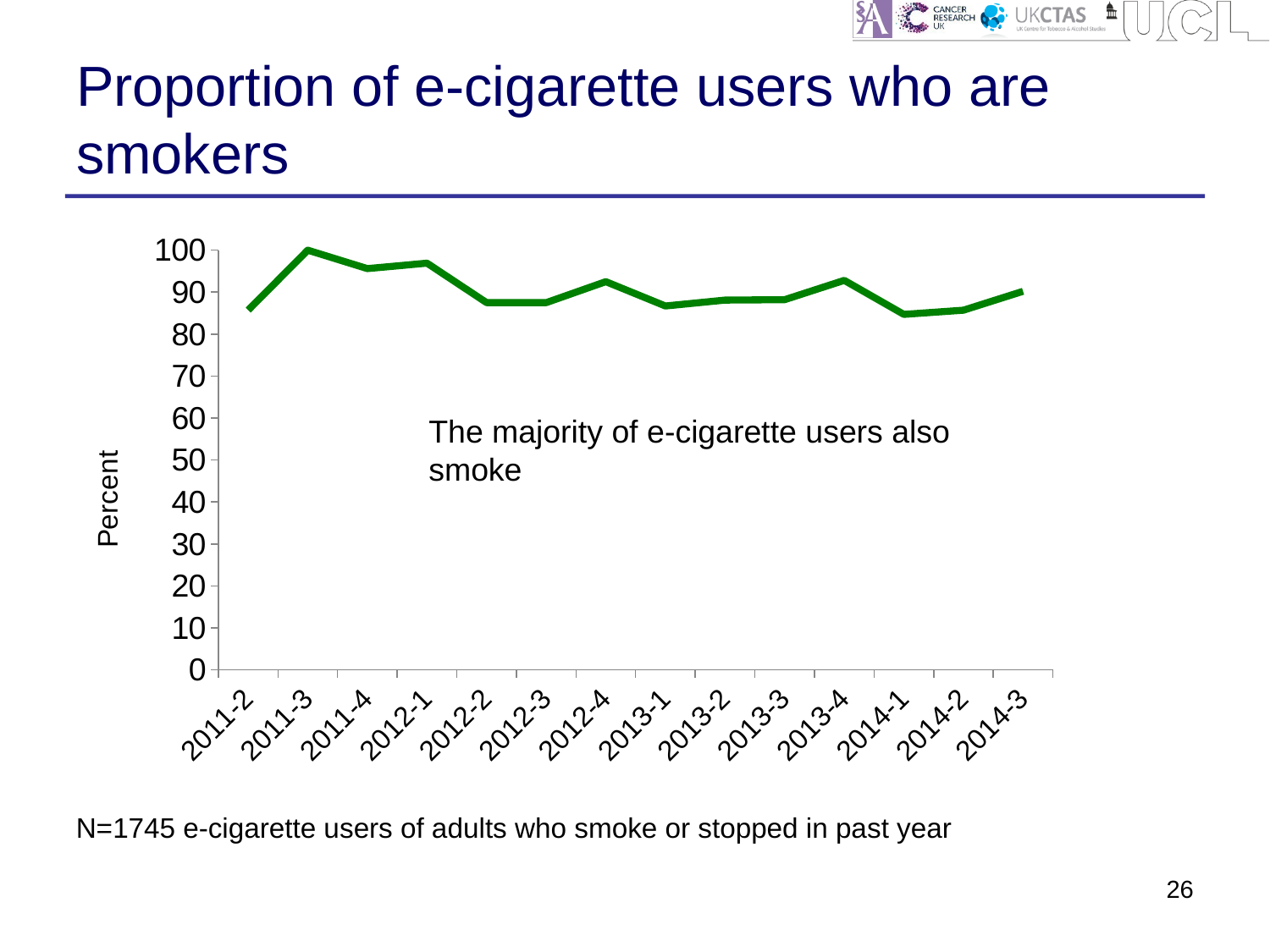
Is the value for 2014-1 greater or less than 90? less Which is larger, the value for 2012-1 or the value for 2013-1? 2012-1 Which is larger, the value for 2011-3 or the value for 2014-1? 2011-3 What is the title of the chart on the slide? Proportion of e-cigarette users who are smokers Does the line rise or fall between 2011-2 and 2011-3? rise Which time point has the highest proportion of e-cigarette users who are smokers? 2011-3 Is the value for 2011-4 greater or less than 90? greater What kind of chart is shown on the slide? line chart Is the value for 2011-2 greater or less than 80? greater What is the label on the y axis? Percent How many time points are plotted along the x axis? 14